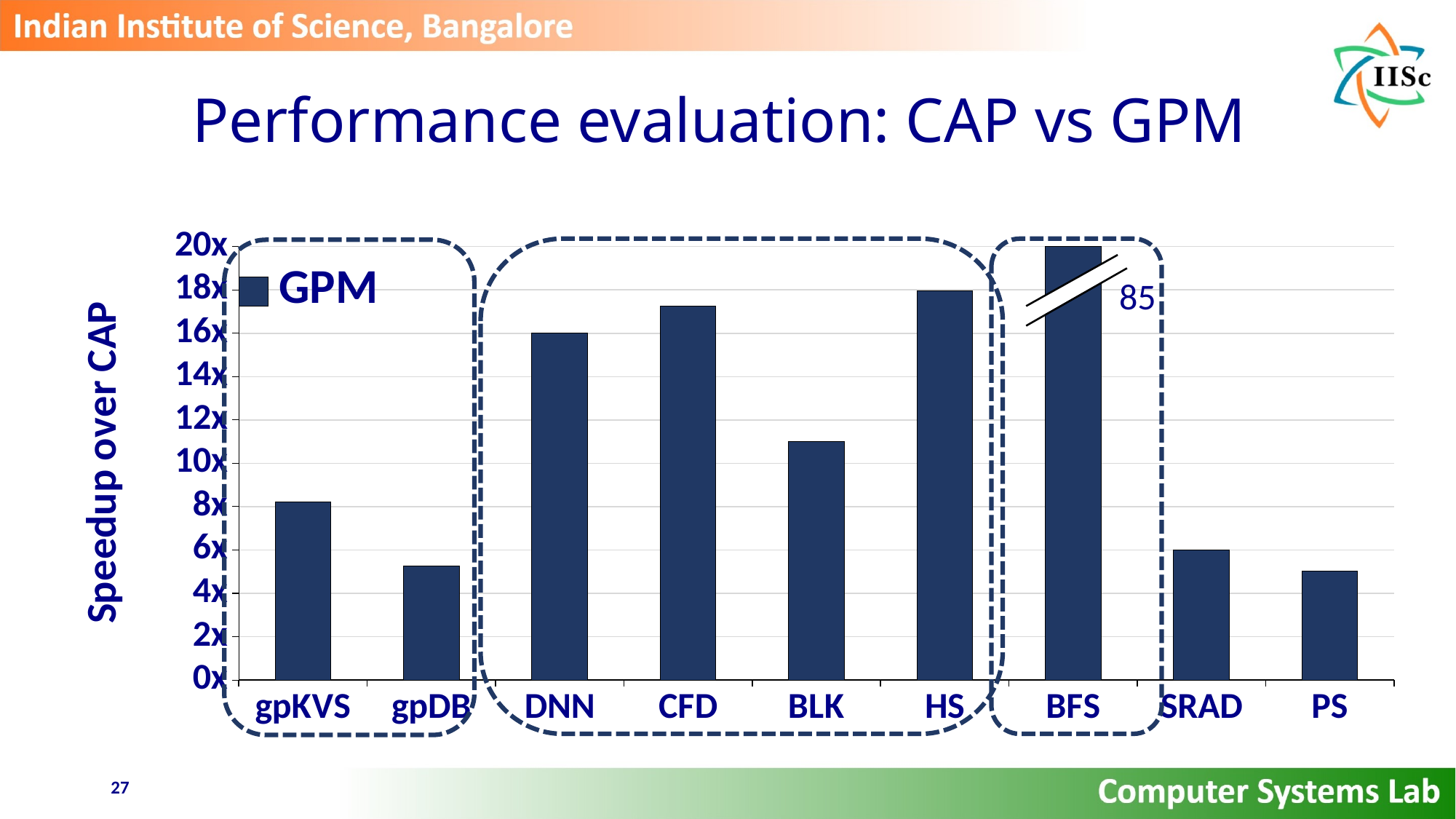
What is the title of the y axis? Speedup over CAP What is the speedup value labelled for BFS? 85 Which category has the highest speedup over CAP? BFS Is the value for BLK greater or less than 10x? greater Which has the larger speedup, HS or DNN? HS Which has the larger speedup, DNN or BLK? DNN How many series does the legend list? 1 How many categories are plotted along the x axis? 9 Is the value for SRAD greater or less than 8x? less Is the value for gpKVS greater or less than 10x? less What kind of chart is shown on the slide? bar chart